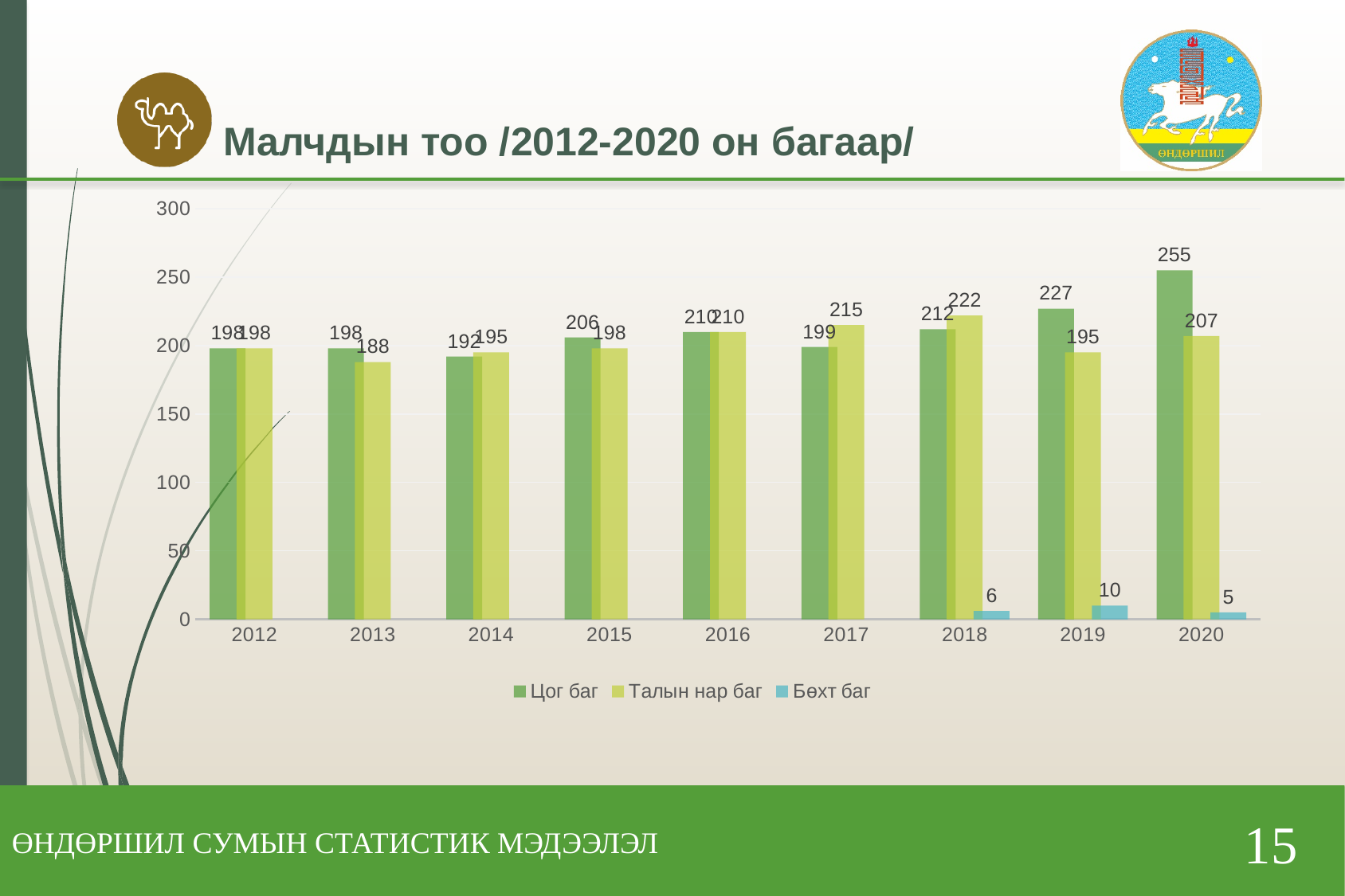
In which year is the value for Бөхт баг lowest? 2020 What is the value for Талын нар баг in 2013? 188 How many series does the legend list? 3 What is the title of the chart? Малчдын тоо /2012-2020 он багаар/ What is the value for Цог баг in 2020? 255 Which is larger in 2017, Цог баг or Талын нар баг? Талын нар баг What kind of chart is shown on the slide? bar chart Is the value for Цог баг in 2019 greater or less than 200? greater How many years are shown on the x axis? 9 In which year is the value for Цог баг highest? 2020 What is the value for Бөхт баг in 2019? 10 What is the difference between Цог баг and Талын нар баг in 2020? 48